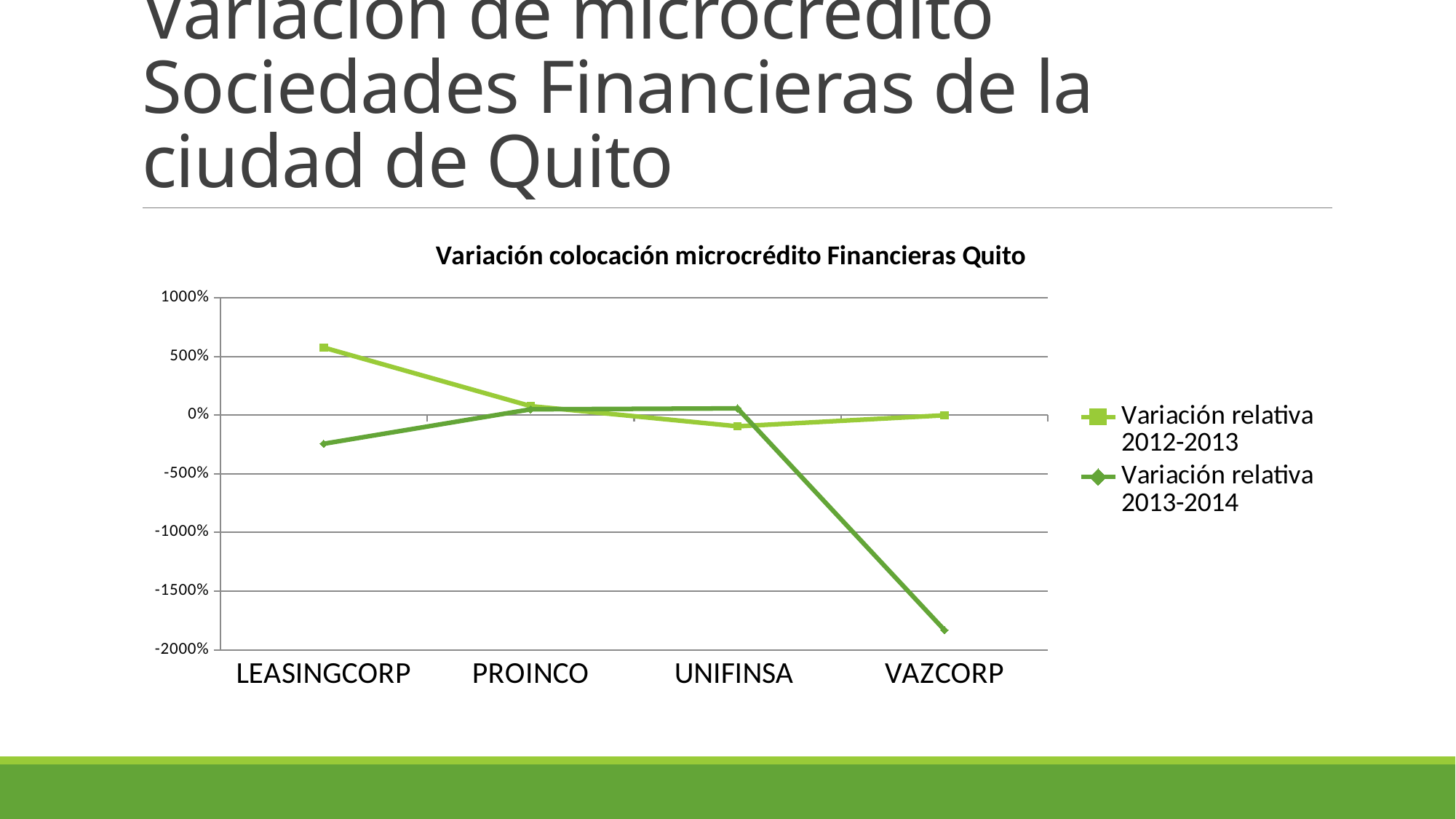
For VAZCORP, which series has the larger value: Variación relativa 2012-2013 or Variación relativa 2013-2014? Variación relativa 2012-2013 How many categories are shown on the x axis of the chart? 4 Which category has the lowest value for the Variación relativa 2013-2014 series? VAZCORP Is the value for VAZCORP in the Variación relativa 2013-2014 series greater or less than -1500%? less Is the value for LEASINGCORP in the Variación relativa 2012-2013 series greater or less than 500%? greater What is the title of the chart? Variación colocación microcrédito Financieras Quito Which category has the highest value for the Variación relativa 2012-2013 series? LEASINGCORP What kind of chart is shown on the slide? line chart For LEASINGCORP, which series has the larger value: Variación relativa 2012-2013 or Variación relativa 2013-2014? Variación relativa 2012-2013 Does the Variación relativa 2013-2014 series rise or fall between UNIFINSA and VAZCORP? fall How many series does the legend list? 2 Is the value for LEASINGCORP in the Variación relativa 2013-2014 series greater or less than 0%? less